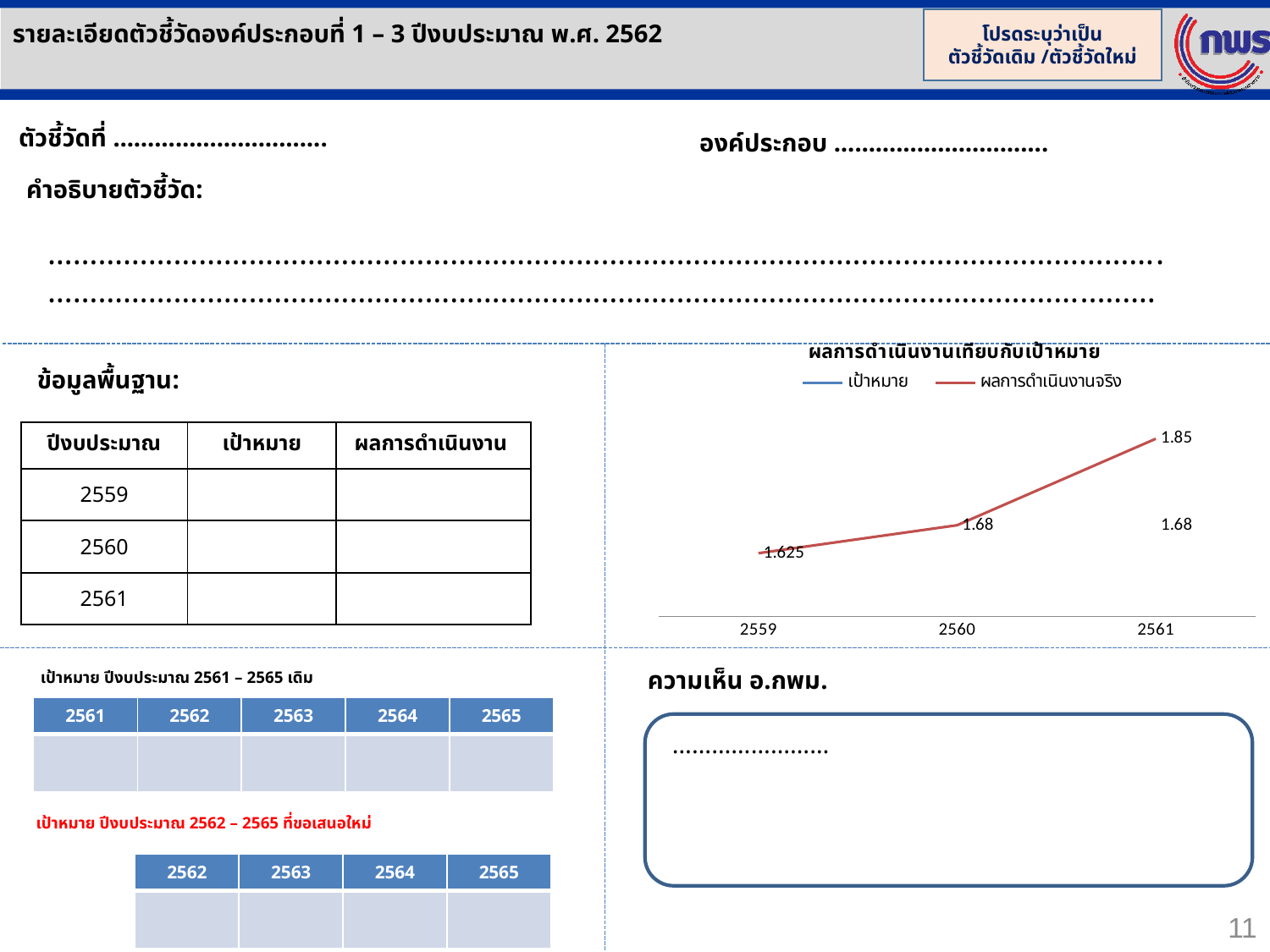
In which year is ผลการดำเนินงานจริง highest? 2561 What is the value of ผลการดำเนินงานจริง in 2559? 1.625 In which year is ผลการดำเนินงานจริง lowest? 2559 What is the value of ผลการดำเนินงานจริง in 2560? 1.68 What kind of chart is shown on the slide? line chart How many years are shown on the x axis of the chart? 3 Which year has the larger ผลการดำเนินงานจริง value, 2560 or 2561? 2561 How many series does the chart legend list? 2 What is the difference between the ผลการดำเนินงานจริง values for 2561 and 2559? 0.225 What is the title of the chart? ผลการดำเนินงานเทียบกับเป้าหมาย Does the ผลการดำเนินงานจริง line rise or fall from 2559 to 2561? rise What is the value of ผลการดำเนินงานจริง in 2561? 1.85